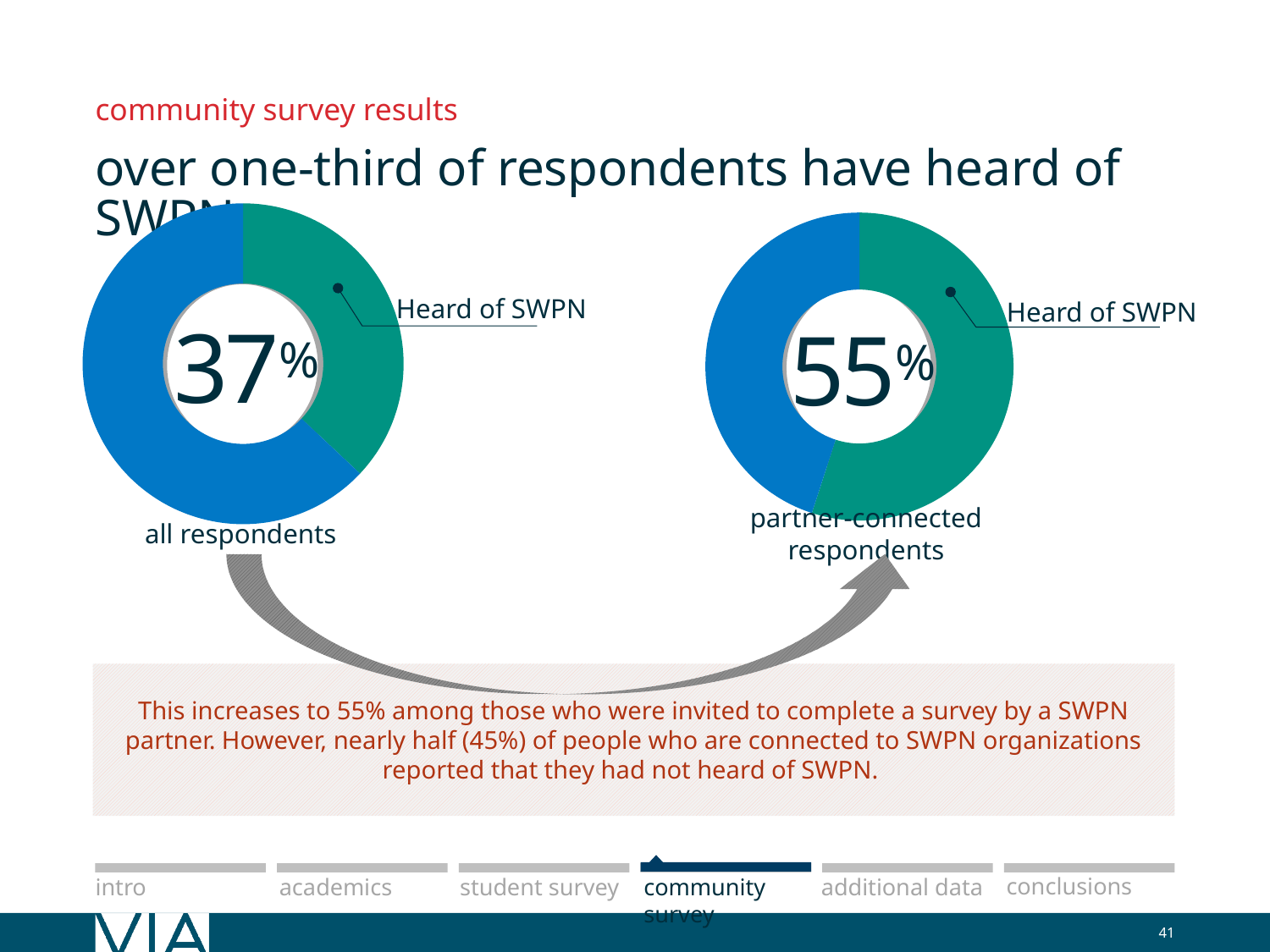
Which group has the larger share that has heard of SWPN: all respondents or partner-connected respondents? partner-connected respondents In the 'all respondents' chart, is the 'Heard of SWPN' share greater or less than 50%? less What is the headline title above the charts? over one-third of respondents have heard of SWPN What colour is the 'Heard of SWPN' slice in both charts? Green In the 'partner-connected respondents' chart, is the 'Heard of SWPN' share greater or less than 50%? greater How many charts are shown on the slide? 2 In the 'all respondents' chart, is the 'Heard of SWPN' slice larger or smaller than the remaining blue slice? smaller In the 'partner-connected respondents' chart, what percentage have heard of SWPN? 55% In the 'all respondents' chart, what percentage of respondents have heard of SWPN? 37% What kind of charts are shown on the slide? Pie (donut) charts In the 'partner-connected respondents' chart, what share of respondents had not heard of SWPN? 45% How many percentage points higher is the 'Heard of SWPN' share for partner-connected respondents than for all respondents? 18 percentage points